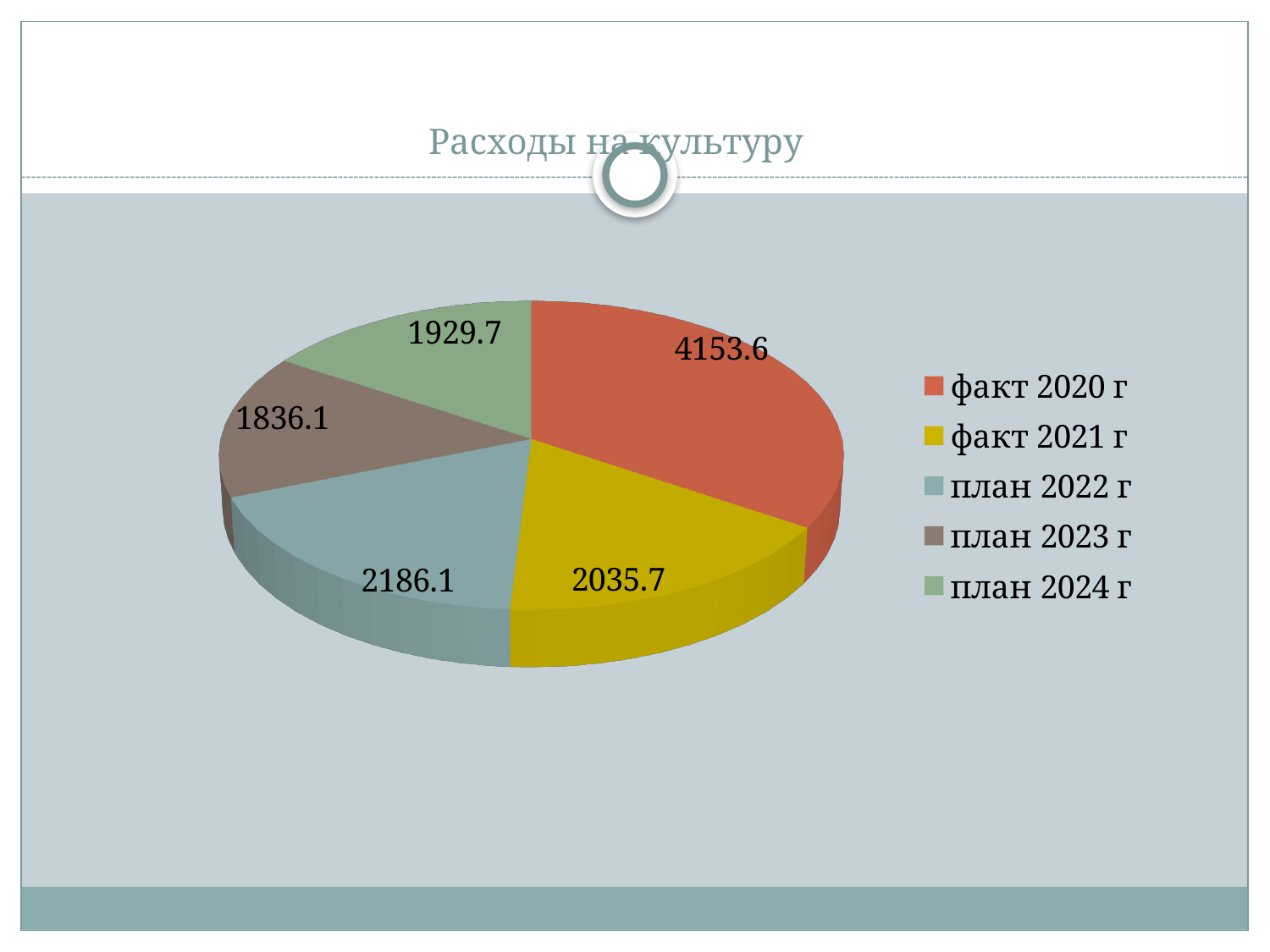
Which category has the largest slice? факт 2020 г What is the value for план 2023 г? 1836.1 What kind of chart is shown on the slide? pie chart How many slices does the pie chart have? 5 What is the difference between план 2022 г and план 2023 г? 350.0 What is the value for план 2022 г? 2186.1 Which is larger, план 2022 г or факт 2021 г? план 2022 г What is the difference between факт 2020 г and факт 2021 г? 2117.9 What is the total of all slices in the pie chart? 12141.2 What is the value for факт 2020 г? 4153.6 Which category has the smallest slice? план 2023 г What is the title of the chart? Расходы на культуру